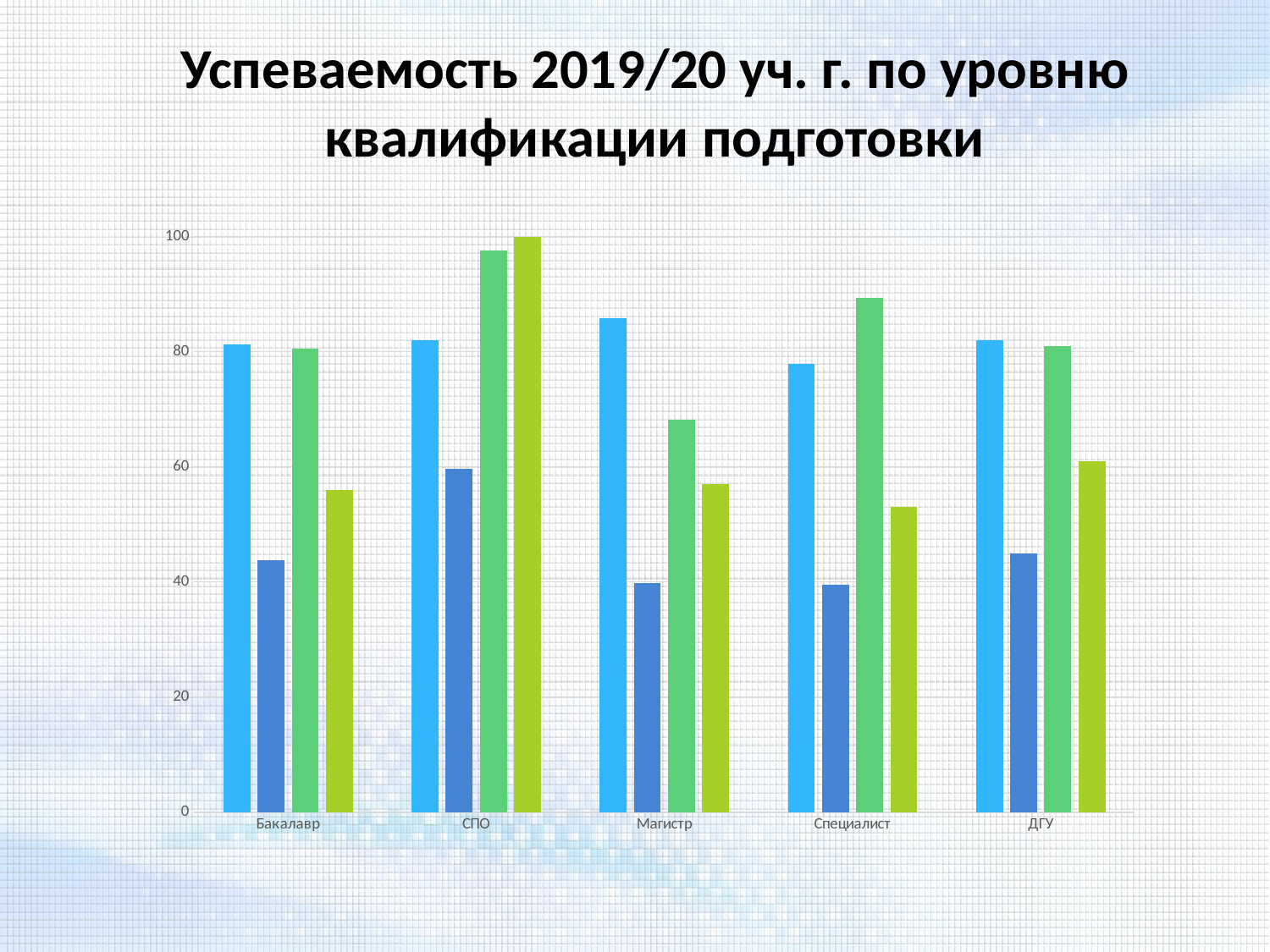
How many categories are shown on the x axis of the chart? 5 How many bars are plotted for each category in the chart? 4 Is the value of the yellow-green bar for Специалист greater or less than 60? less Is the value of the green bar for СПО greater or less than 80? greater Among the light blue bars, which category has the highest value? Магистр Is the value of the dark blue bar for Бакалавр greater or less than 60? less Among the dark blue bars, which category has the highest value? СПО What is the title of the slide containing the chart? Успеваемость 2019/20 уч. г. по уровню квалификации подготовки For Магистр, which is larger: the light blue bar or the dark blue bar? the light blue bar What kind of chart is shown on the slide? bar chart Among the green bars, which category has the lowest value? Магистр